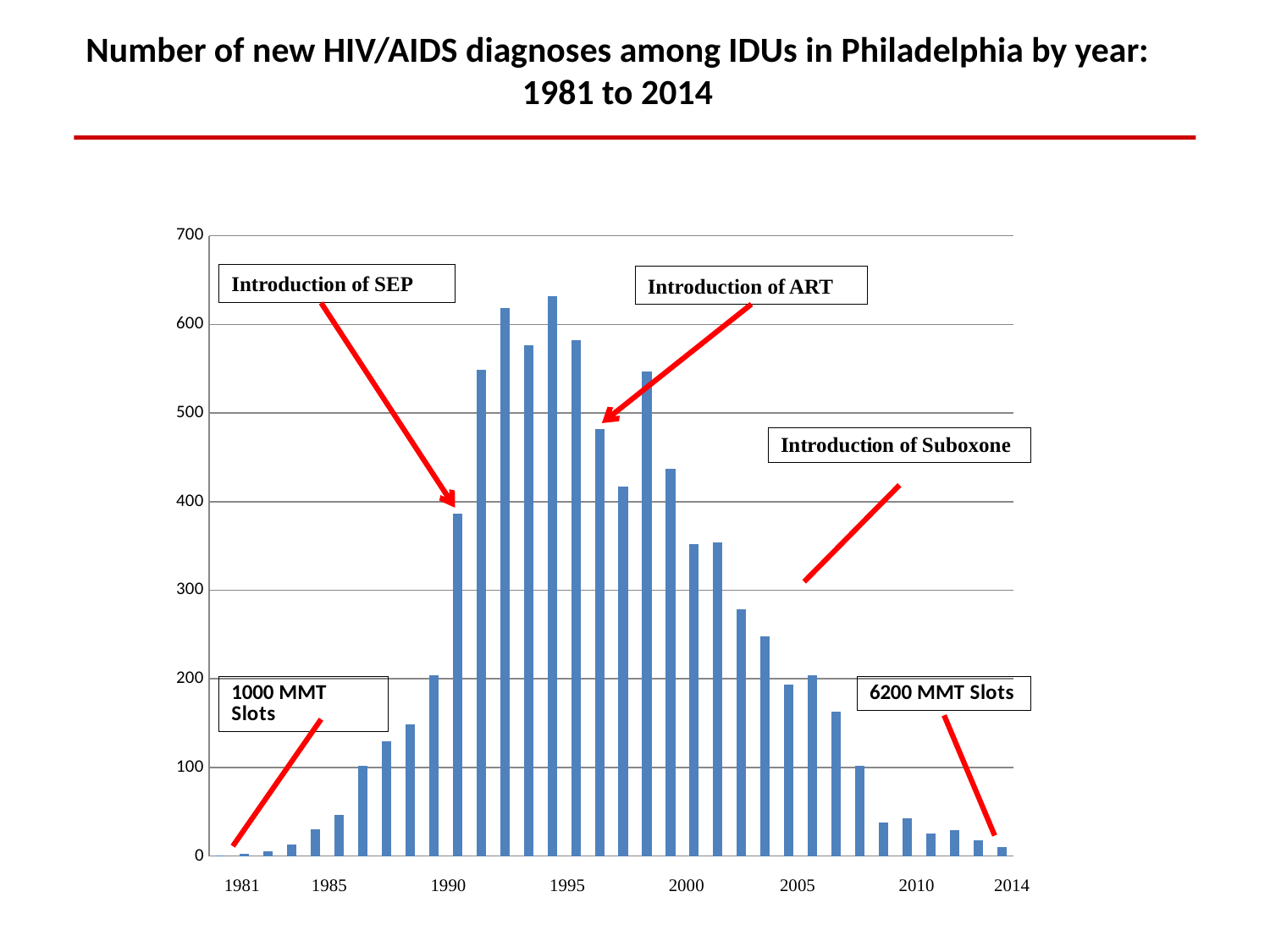
Is the value for 1995 greater or less than 500? greater What kind of chart is shown on the slide? bar chart Which intervention does the annotation arrow pointing at the 1990 bar label? Introduction of SEP Is the value for 1990 greater or less than 300? less Is the value for 2010 greater or less than 100? less What is the title of the chart? Number of new HIV/AIDS diagnoses among IDUs in Philadelphia by year: 1981 to 2014 Which year has the larger value, 1990 or 1995? 1995 Which year has the larger value, 2000 or 2010? 2000 Do the values generally rise or fall from 2000 to 2014? fall